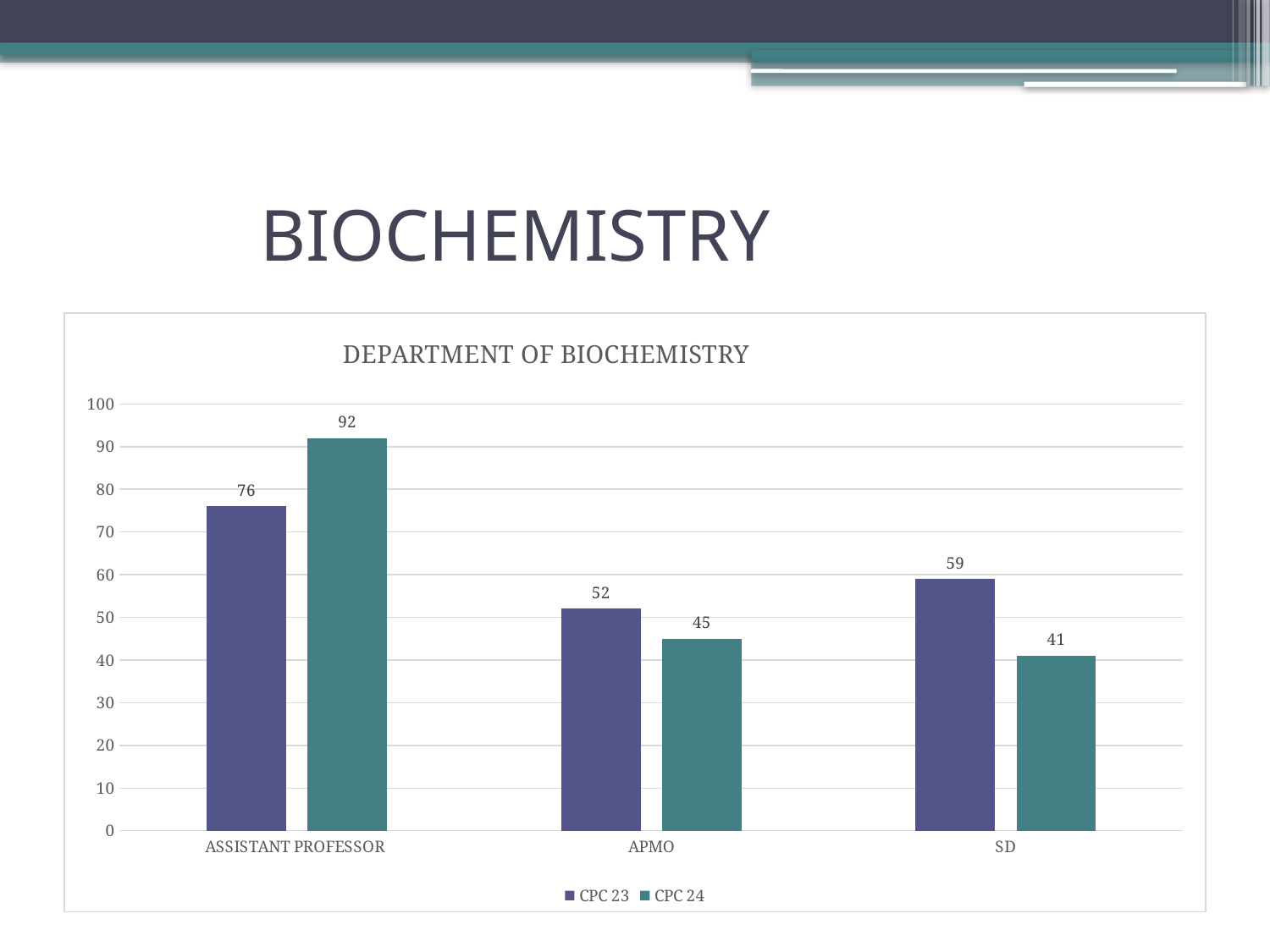
What kind of chart is shown? Bar chart What is the value for CPC 24 for SD? 41 Which is larger for APMO, CPC 23 or CPC 24? CPC 23 What is the value for CPC 24 for APMO? 45 How many categories are shown on the x axis? 3 What is the difference between the CPC 23 and CPC 24 values for SD? 18 What is the difference between the CPC 24 and CPC 23 values for ASSISTANT PROFESSOR? 16 What is the title of the chart? DEPARTMENT OF BIOCHEMISTRY What is the value for CPC 23 for ASSISTANT PROFESSOR? 76 How many series does the legend list? 2 Which category has the lowest CPC 23 value? APMO Which category has the highest CPC 24 value? ASSISTANT PROFESSOR